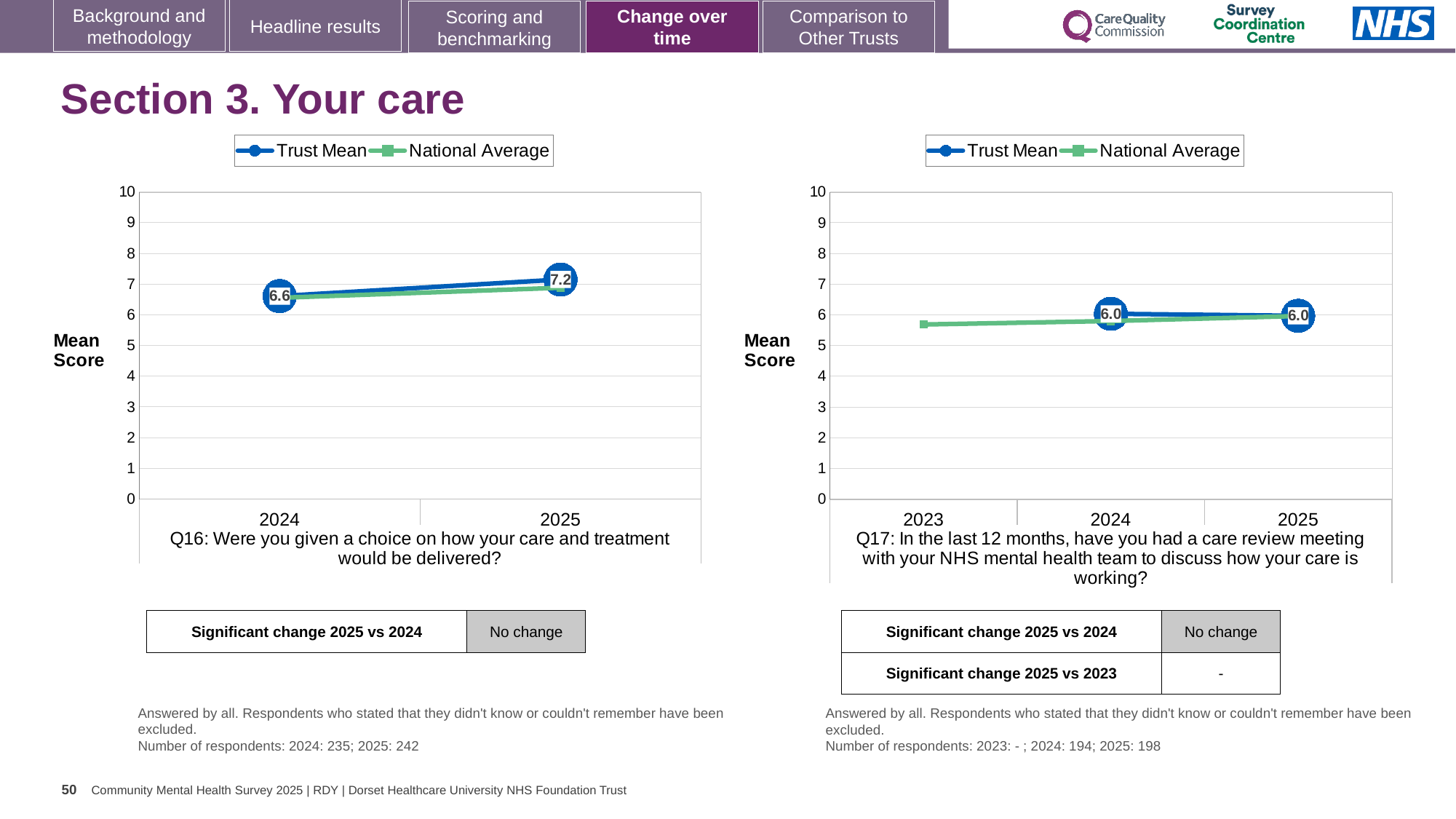
In the Q16 chart on the left, what is the Trust Mean for 2025? 7.2 In the Q16 chart on the left, by how much did the Trust Mean change from 2024 to 2025? 0.6 In the Q16 chart on the left, which year has the higher Trust Mean, 2024 or 2025? 2025 In the Q16 chart on the left, is the National Average for 2024 greater or less than 6? greater How many years are shown on the x axis of the Q17 chart on the right? 3 How many series does the legend of the Q16 chart on the left list? 2 In the Q17 chart on the right, is the National Average for 2023 greater or less than 6? less In the Q16 chart on the left, what is the Trust Mean for 2024? 6.6 In the Q17 chart on the right, does the Trust Mean rise, fall or stay the same from 2024 to 2025? stay the same In the Q17 chart on the right, what is the Trust Mean for 2025? 6.0 In the Q16 chart on the left, does the Trust Mean rise or fall from 2024 to 2025? rise What kind of chart is the Q17 chart on the right? line chart